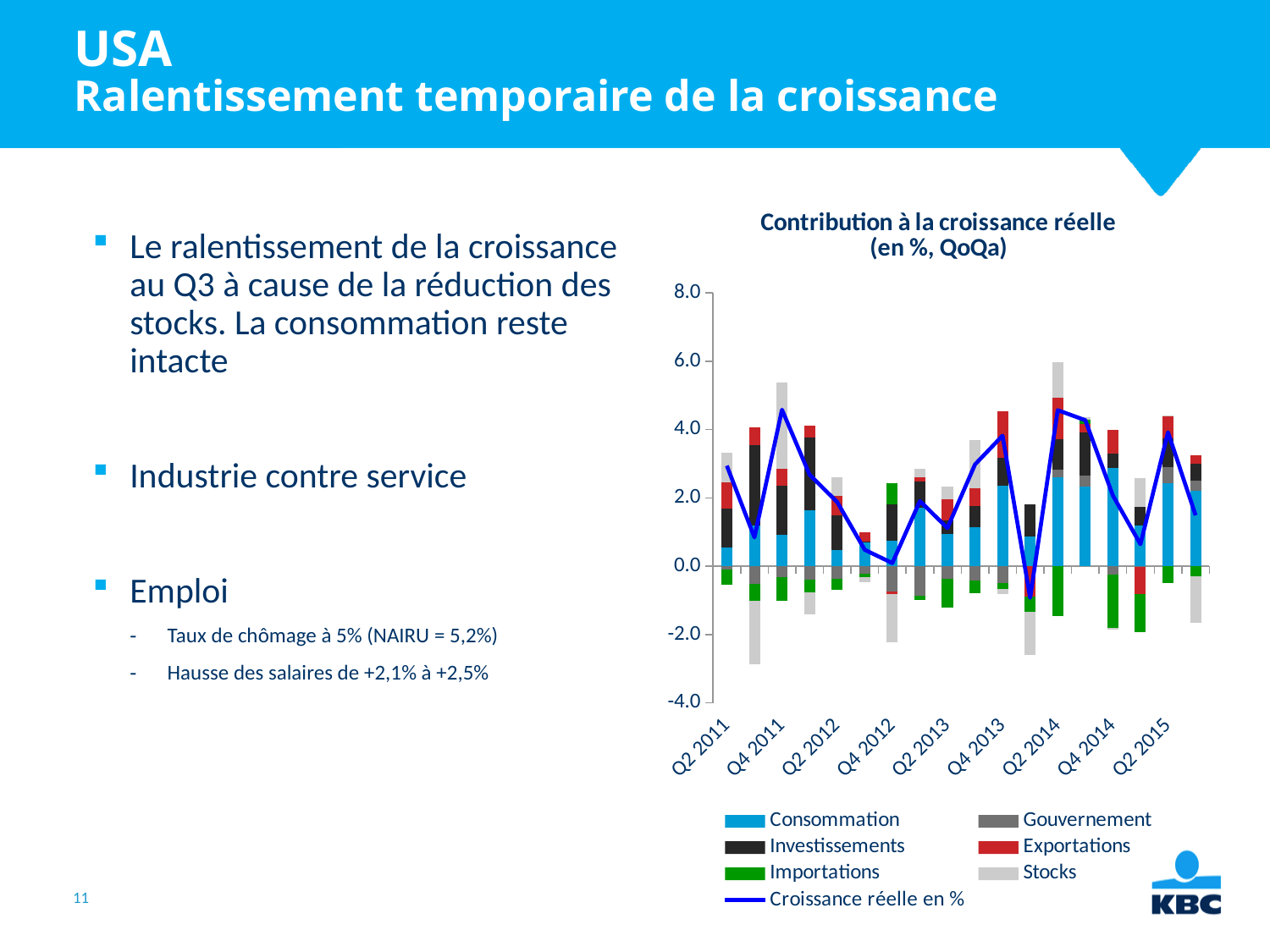
What kind of chart is shown on the slide? bar chart (stacked, with a line) Is the value of the 'Croissance réelle en %' line for Q4 2011 greater or less than 4.0? greater Is the value of the 'Croissance réelle en %' line for Q2 2011 greater or less than 2.0? greater Which of the labeled quarters on the x axis has the lowest value of the 'Croissance réelle en %' line? Q4 2012 What is the title of the chart? Contribution à la croissance réelle (en %, QoQa) Which has the larger value of the 'Croissance réelle en %' line: Q4 2011 or Q4 2012? Q4 2011 How many quarter labels are printed on the x axis of the chart? 9 Is the value of the 'Croissance réelle en %' line for Q4 2012 greater or less than 2.0? less What is the highest value shown on the chart's y axis? 8.0 How many series does the chart's legend list? 7